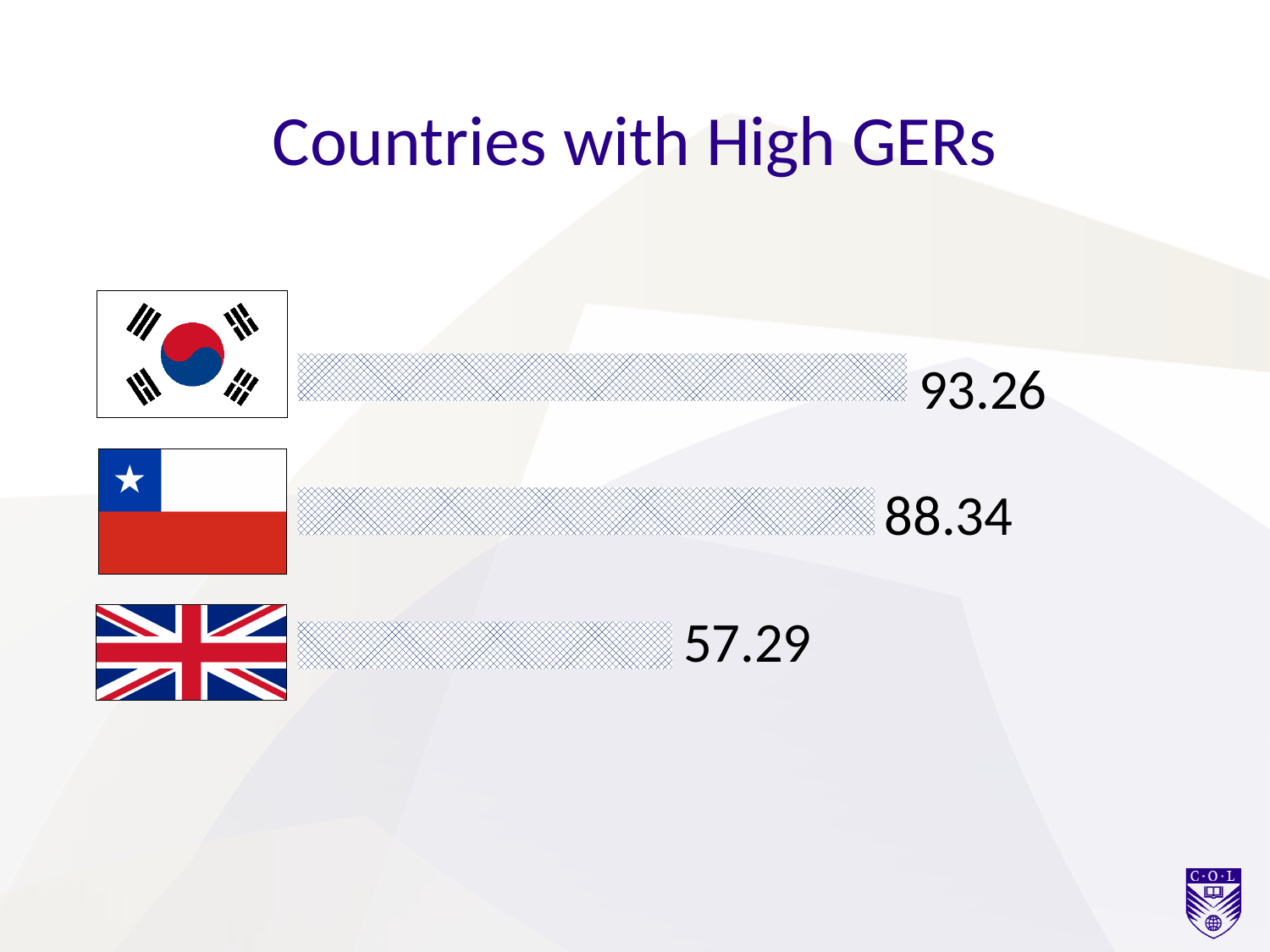
What is the difference between the values for South Korea and Chile? 4.92 How many bars are shown on the chart? 3 What is the value of the middle bar (next to the Chilean flag)? 88.34 What is the value of the bottom bar (next to the United Kingdom flag)? 57.29 Which country has the lowest value on the chart? United Kingdom What kind of chart is shown on the slide? bar chart What is the value of the top bar (next to the South Korean flag)? 93.26 What is the difference between the values for Chile and the United Kingdom? 31.05 What is the title of the slide? Countries with High GERs How are the categories labelled on the chart? with country flags Which is larger, the value for Chile or the value for the United Kingdom? Chile Which country has the highest value on the chart? South Korea